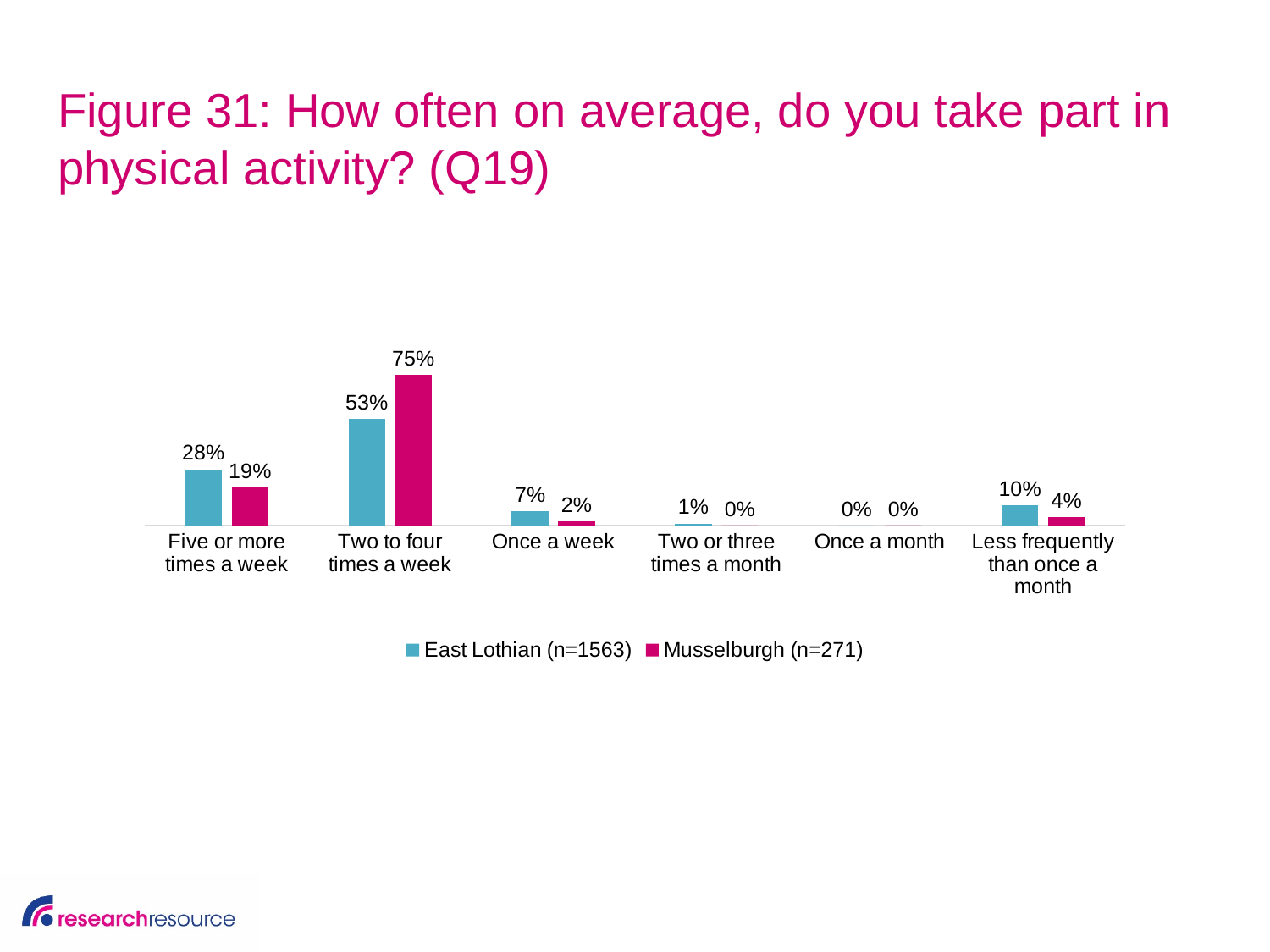
Which category has the highest value for East Lothian? Two to four times a week What is the value for Musselburgh for 'Less frequently than once a month'? 4% How many series does the legend list? 2 What percentage of Musselburgh respondents take part in physical activity five or more times a week? 19% What is the difference between the East Lothian and Musselburgh values for 'Five or more times a week'? 9 percentage points For 'Once a week', which area has the larger value, East Lothian or Musselburgh? East Lothian How many categories are shown on the x axis? 6 What is the difference between the Musselburgh and East Lothian values for 'Two to four times a week'? 22 percentage points What percentage of East Lothian respondents take part in physical activity two to four times a week? 53% What is the sample size (n) for Musselburgh shown in the legend? 271 Which category has the highest value for Musselburgh? Two to four times a week What kind of chart is shown on the slide? Bar chart